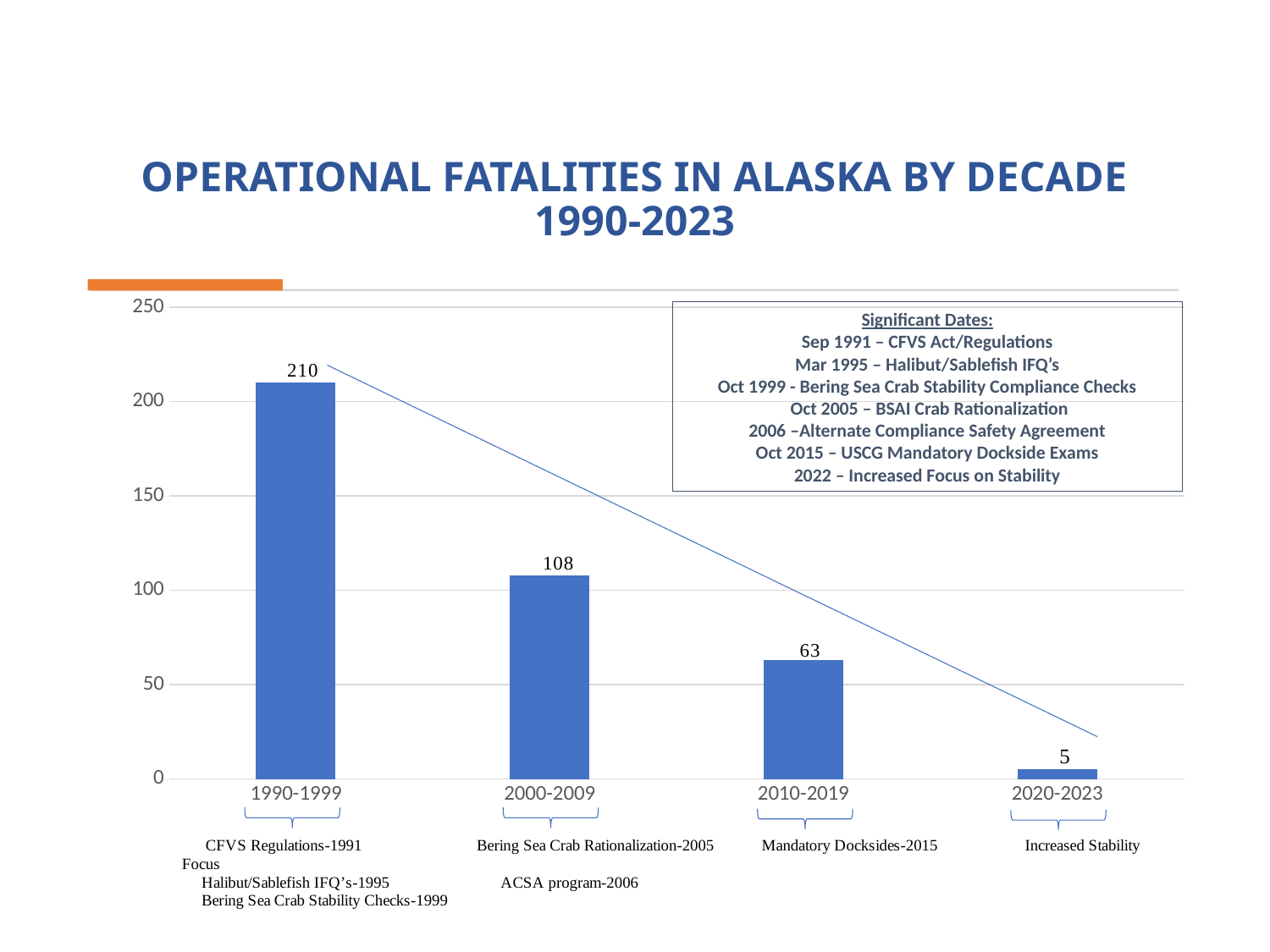
What is the difference between the values for 1990-1999 and 2000-2009? 102 Which period has the lowest number of fatalities? 2020-2023 What is the value for 1990-1999? 210 Which decade has the highest number of fatalities? 1990-1999 What is the value for 2020-2023? 5 Is the value for 2010-2019 greater or less than 100? less What is the value for 2000-2009? 108 What is the value for 2010-2019? 63 Which is larger, the value for 2000-2009 or the value for 2010-2019? 2000-2009 What kind of chart is shown on the slide? bar chart How many time periods are shown on the x axis? 4 Do the values rise or fall from 1990-1999 to 2020-2023? fall